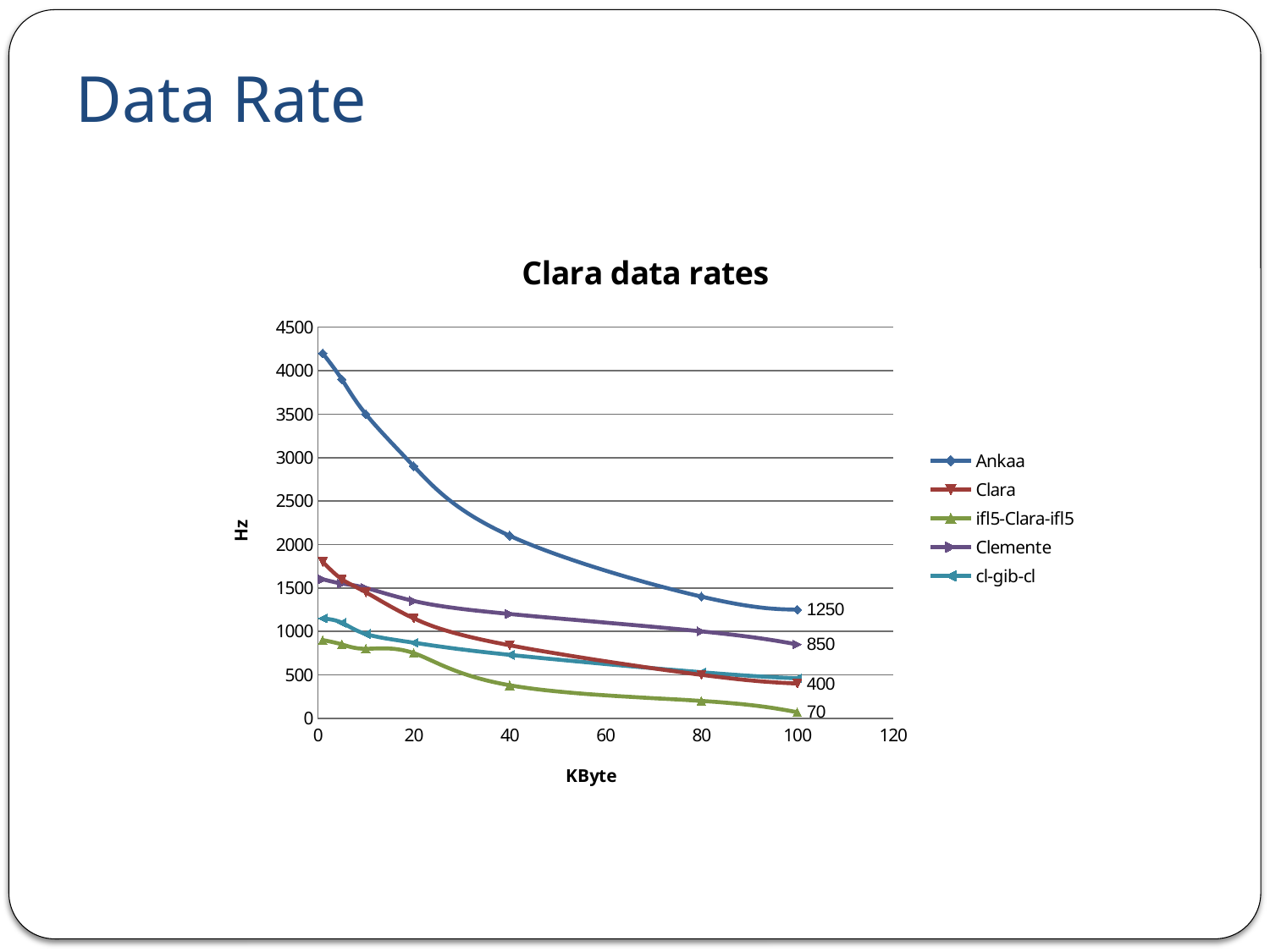
What kind of chart is shown on the slide? line chart What is the title of the chart? Clara data rates What is the data rate for Ankaa at 100 KByte? 1250 Is the value for Ankaa at 0 KByte greater or less than 4000? greater How many series does the legend list? 5 Does the Ankaa series rise or fall as KByte increases? fall What is the data rate for Clemente at 100 KByte? 850 Which series has the highest value at 100 KByte? Ankaa What is the difference between the Ankaa and Clemente values at 100 KByte? 400 What is the label on the y axis? Hz Which series has the lowest value at 100 KByte? ifl5-Clara-ifl5 What is the data rate for ifl5-Clara-ifl5 at 100 KByte? 70